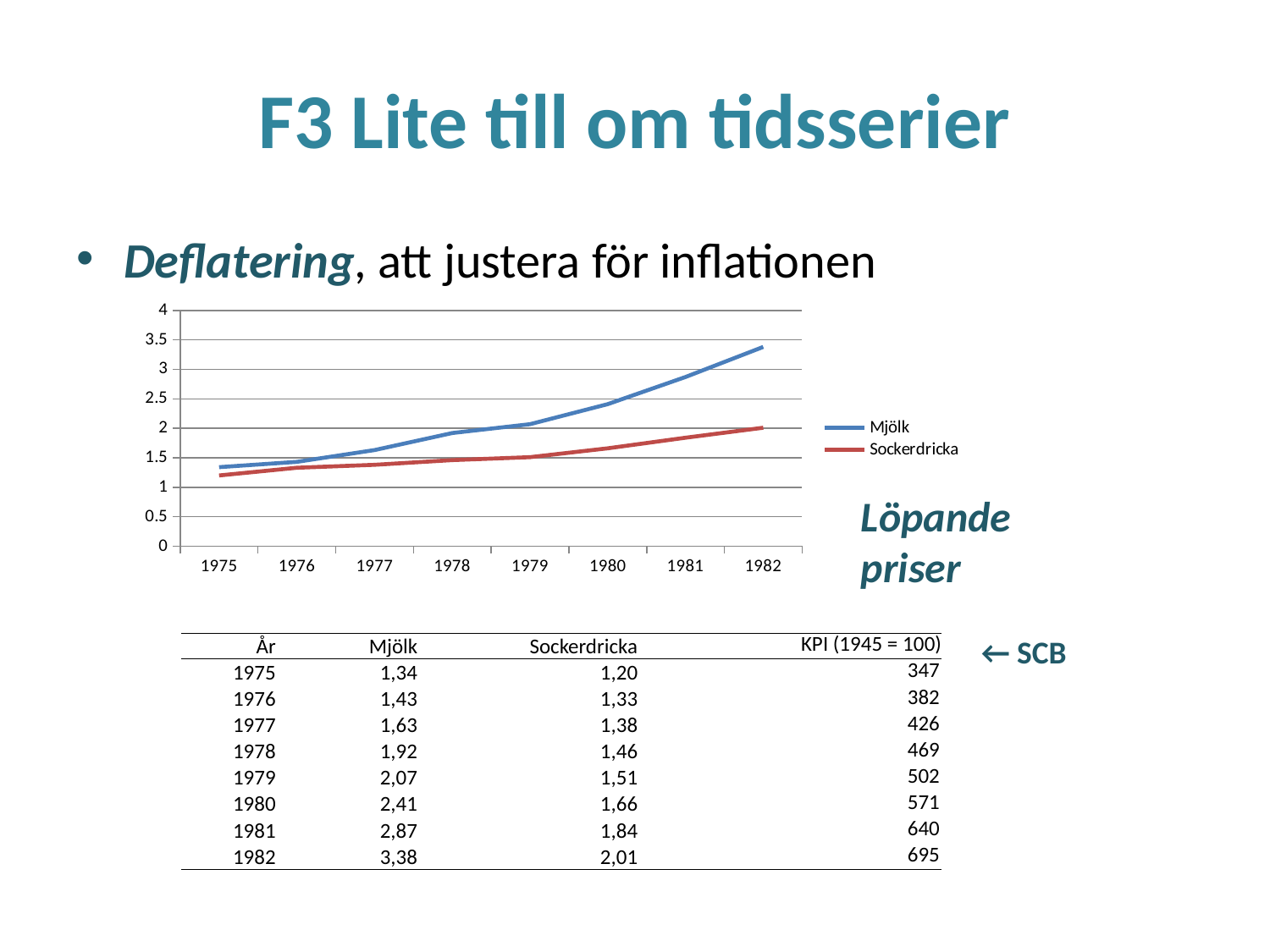
What colour is the Mjölk line in the chart? blue What kind of chart is shown on the slide? line chart Using the values in the table, what is the difference between Mjölk in 1982 and Mjölk in 1975? 2,04 How many years are plotted along the x axis of the chart? 8 In 1980, which series has the larger value, Mjölk or Sockerdricka? Mjölk In which year does the Mjölk series reach its highest value? 1982 Is the value for Sockerdricka in 1979 greater or less than 2? less According to the table on the slide, what is the value for Sockerdricka in 1975? 1,20 How many series does the chart's legend list? 2 According to the table on the slide, what is the value for Mjölk in 1982? 3,38 Does the Mjölk series rise or fall from 1975 to 1982? rise Is the value for Mjölk in 1982 greater or less than 3? greater